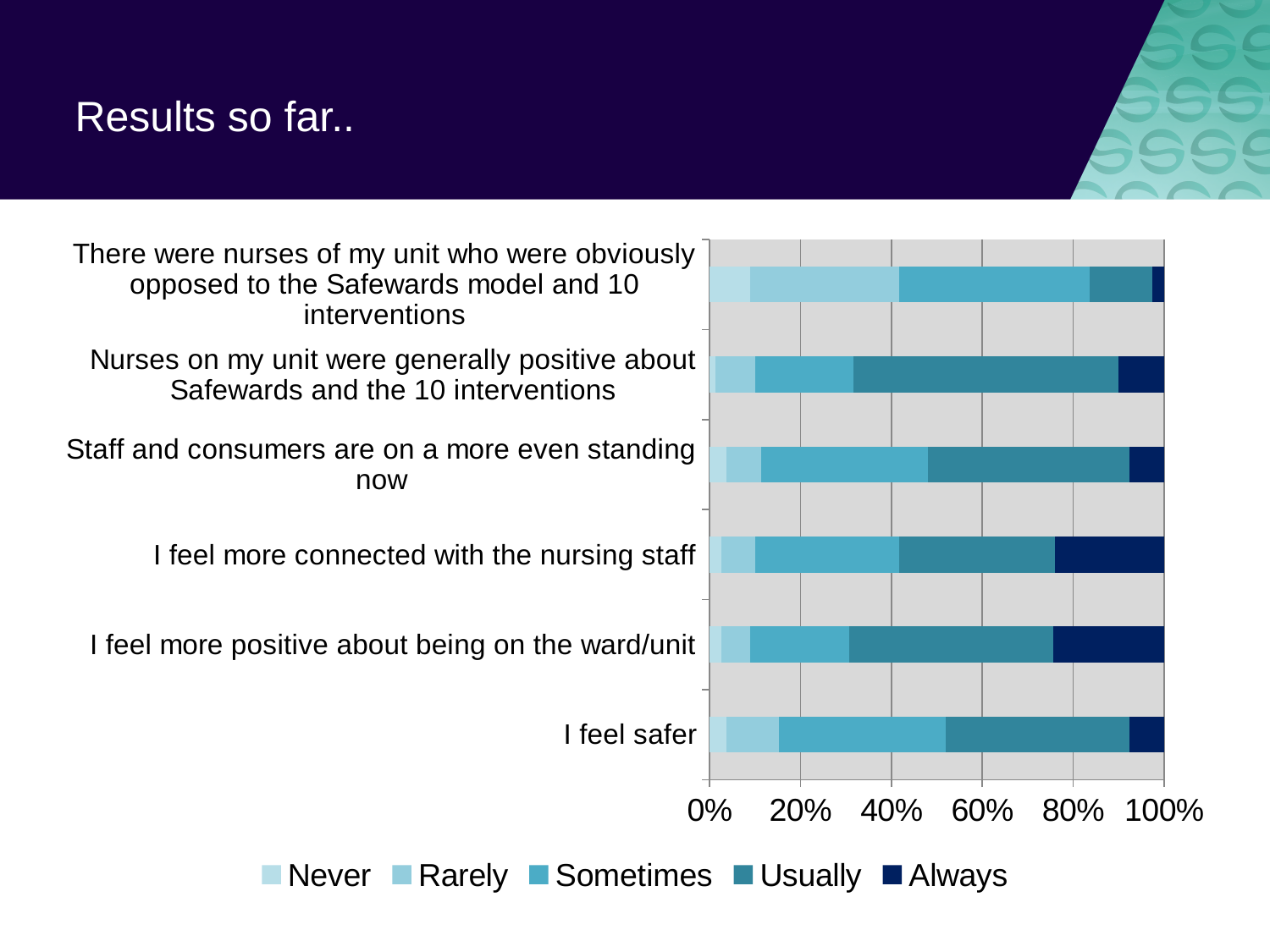
What are the five response categories listed in the legend? Never, Rarely, Sometimes, Usually, Always What is the title of the slide containing the chart? Results so far.. Is the 'Always' share for 'I feel safer' greater or less than 20%? less Which statement has the smallest 'Always' share? There were nurses of my unit who were obviously opposed to the Safewards model and 10 interventions How many statements (categories) are plotted in the chart? 6 Which statement has the largest 'Usually' share? Nurses on my unit were generally positive about Safewards and the 10 interventions Which has the larger 'Always' share: 'I feel more connected with the nursing staff' or 'I feel safer'? I feel more connected with the nursing staff Is the 'Usually' share for 'Nurses on my unit were generally positive about Safewards and the 10 interventions' greater or less than 40%? greater Is the 'Rarely' share for 'There were nurses of my unit who were obviously opposed to the Safewards model and 10 interventions' greater or less than 20%? greater What kind of chart is shown on the slide? Stacked bar chart What value does each stacked bar reach on the x axis? 100% How many series does the legend list? 5